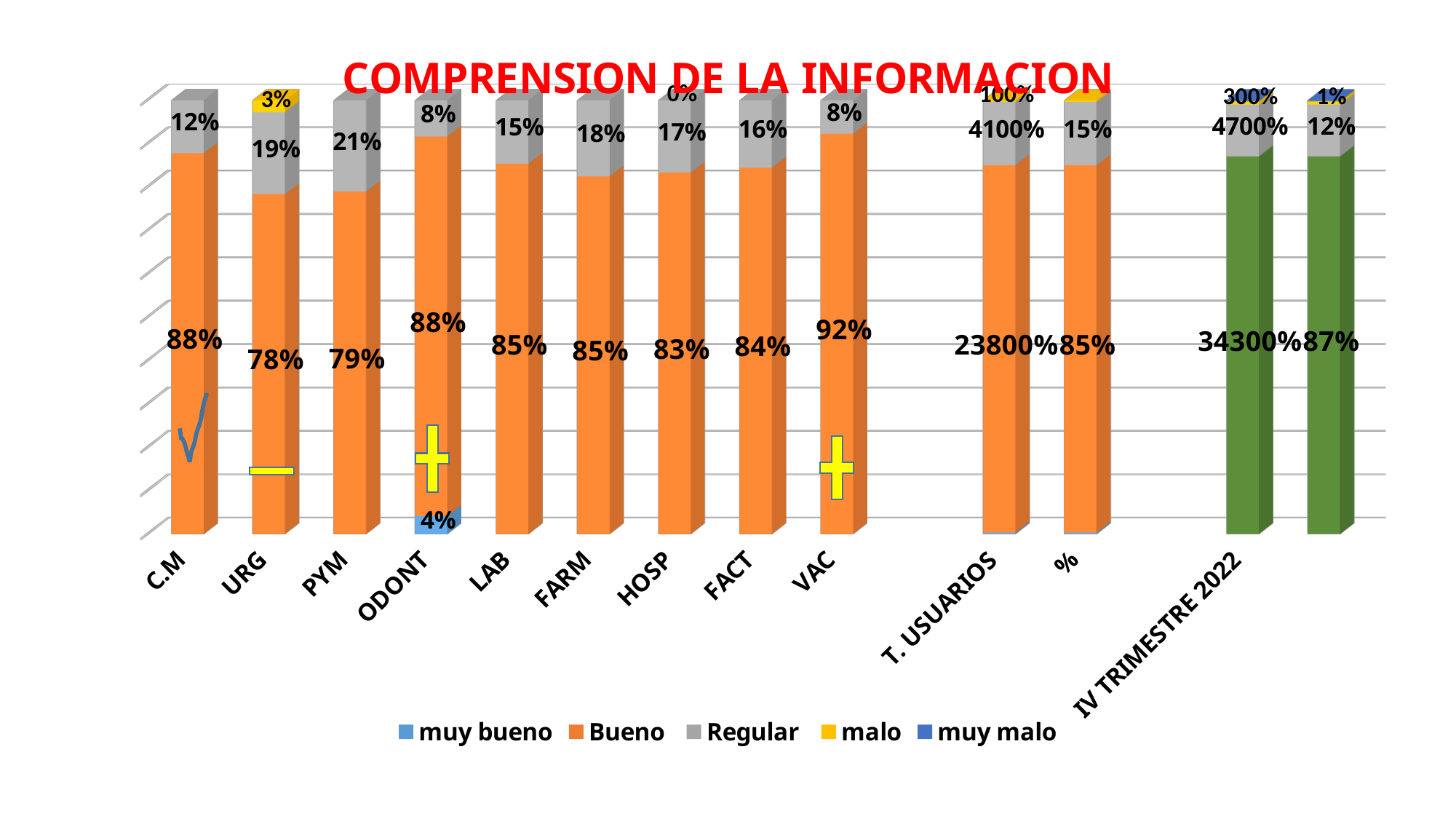
What is the Regular value for PYM? 21% What is the Bueno value for VAC? 92% How many series does the legend list? 5 What is the muy bueno value for ODONT? 4% Among C.M, URG, PYM, ODONT, LAB, FARM, HOSP, FACT and VAC, which category has the lowest Bueno value? URG What is the Bueno value for HOSP? 83% What kind of chart is shown on the slide? stacked bar chart Among C.M, URG, PYM, ODONT, LAB, FARM, HOSP, FACT and VAC, which category has the highest Bueno value? VAC What is the malo value for URG? 3% Which has a larger Regular value, PYM or C.M? PYM What is the difference between the Bueno values for VAC and URG? 14% What is the title of the chart? COMPRENSION DE LA INFORMACION